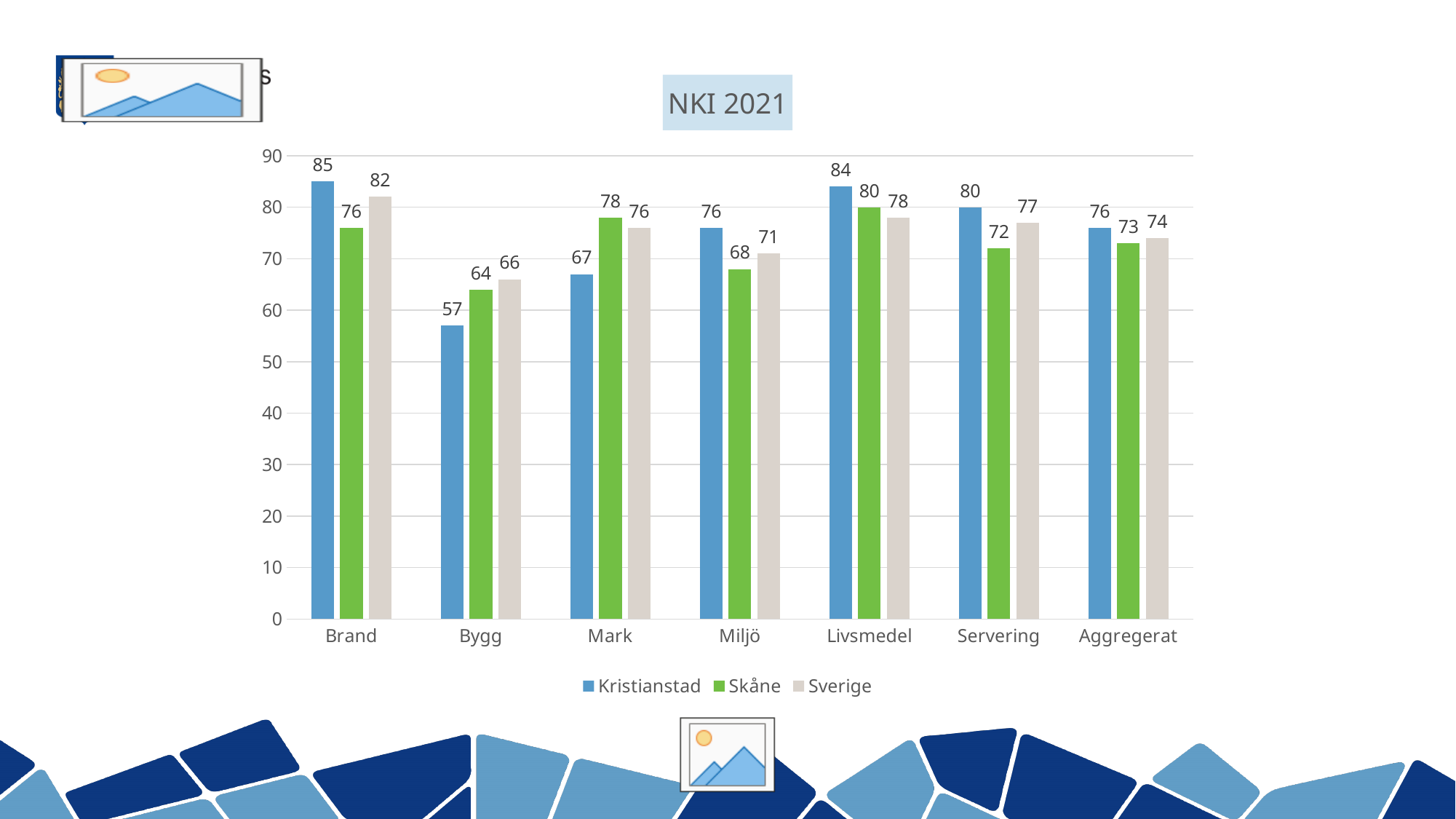
How many series does the legend list? 3 What colour are the bars for the Skåne series? Green What is the value for Sverige in the Miljö category? 71 What is the difference between the Skåne and Kristianstad values in the Mark category? 11 What kind of chart is shown on the slide? Bar chart What is the value for Kristianstad in the Brand category? 85 How many categories are shown on the x axis? 7 Which category has the highest value for Skåne? Livsmedel Which category has the lowest value for Kristianstad? Bygg What is the value for Skåne in the Servering category? 72 In the Bygg category, which is larger: the Kristianstad value or the Sverige value? Sverige What is the title of the chart? NKI 2021